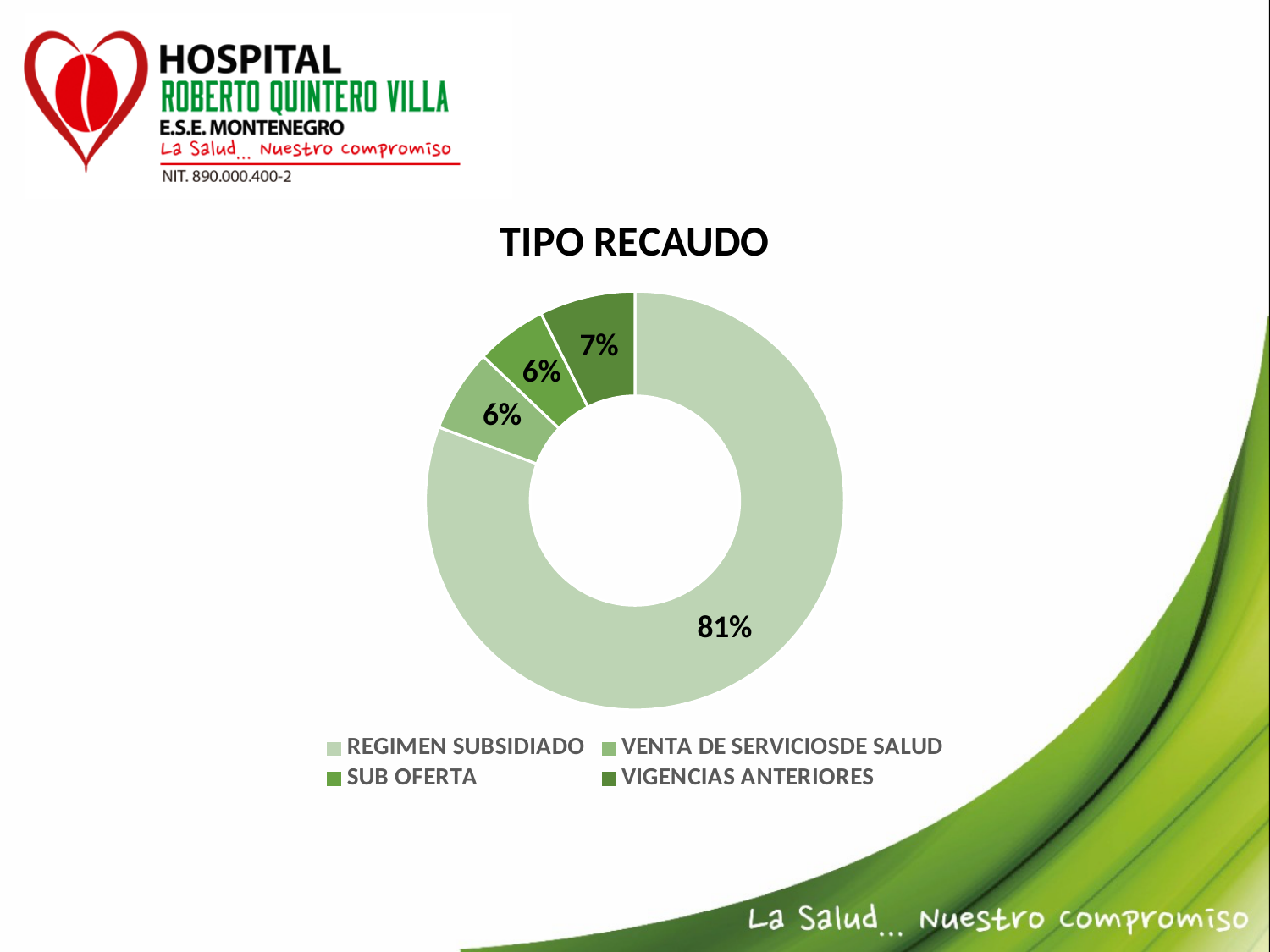
How many categories does the chart show? 4 What percentage is shown for VENTA DE SERVICIOSDE SALUD? 6% What is the title of the chart? TIPO RECAUDO What share of the chart does REGIMEN SUBSIDIADO represent? 81% What is the difference in percentage points between REGIMEN SUBSIDIADO and VIGENCIAS ANTERIORES? 74 percentage points Which legend entry is listed first? REGIMEN SUBSIDIADO What percentage is shown for SUB OFERTA? 6% Which category has the largest share of the chart? REGIMEN SUBSIDIADO What percentage is shown for VIGENCIAS ANTERIORES? 7% What kind of chart is shown on the slide? Doughnut (pie) chart Is the share for REGIMEN SUBSIDIADO greater or less than 50%? greater Which is larger, the share for VIGENCIAS ANTERIORES or the share for SUB OFERTA? VIGENCIAS ANTERIORES